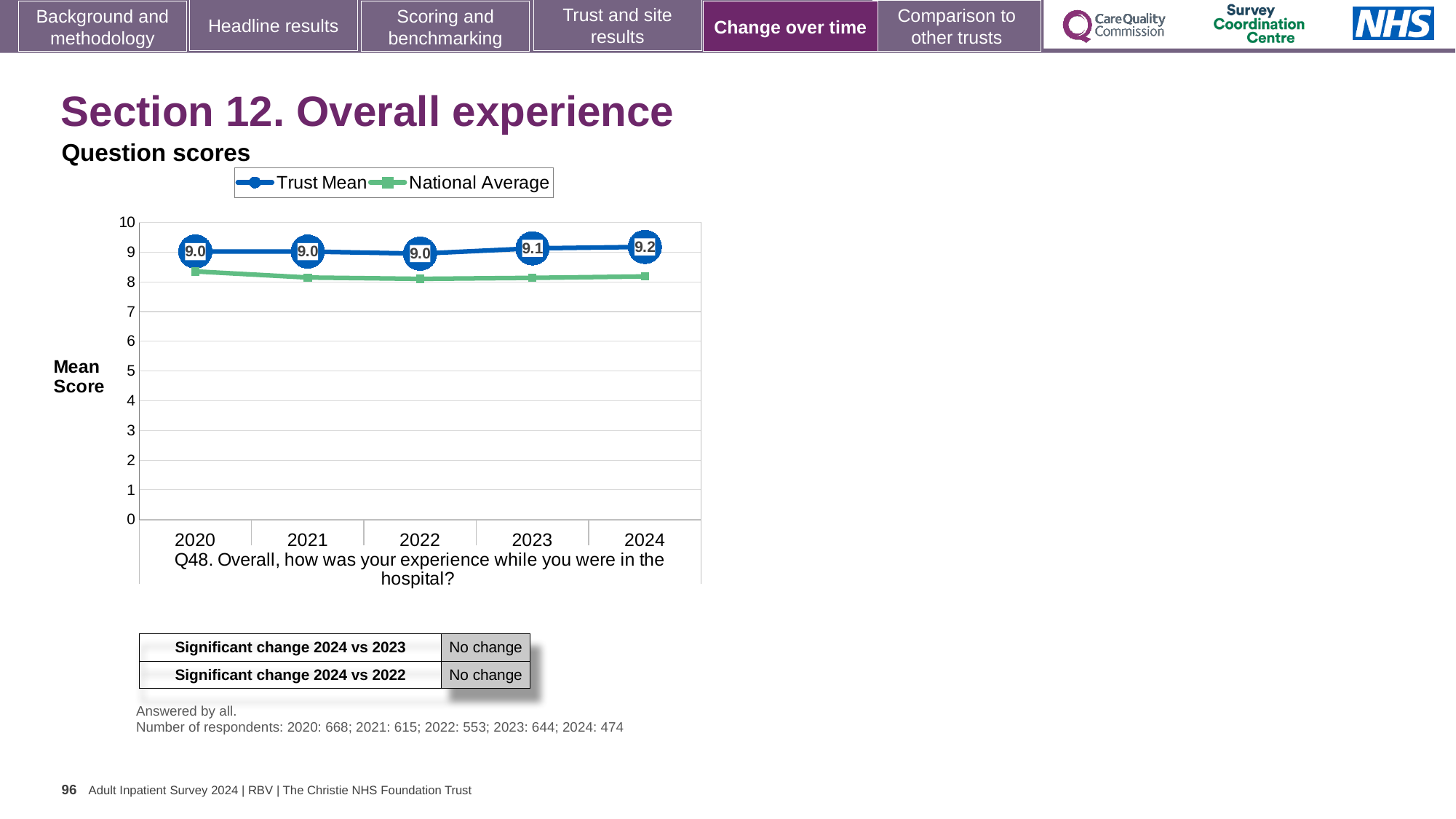
How many series does the chart legend list? 2 What is the difference between the Trust Mean score in 2024 and in 2022? 0.2 How many years are shown on the x axis of the chart? 5 Which is larger in 2024, the Trust Mean or the National Average? Trust Mean What is the Trust Mean score for 2020? 9.0 Does the Trust Mean score rise or fall from 2022 to 2024? Rise Is the National Average value for 2022 greater or less than 9? less What kind of chart is shown on the slide? Line chart What is the Trust Mean score for 2024? 9.2 In which year is the Trust Mean score highest? 2024 Is the National Average value for 2020 greater or less than 8? greater What is the Trust Mean score for 2023? 9.1